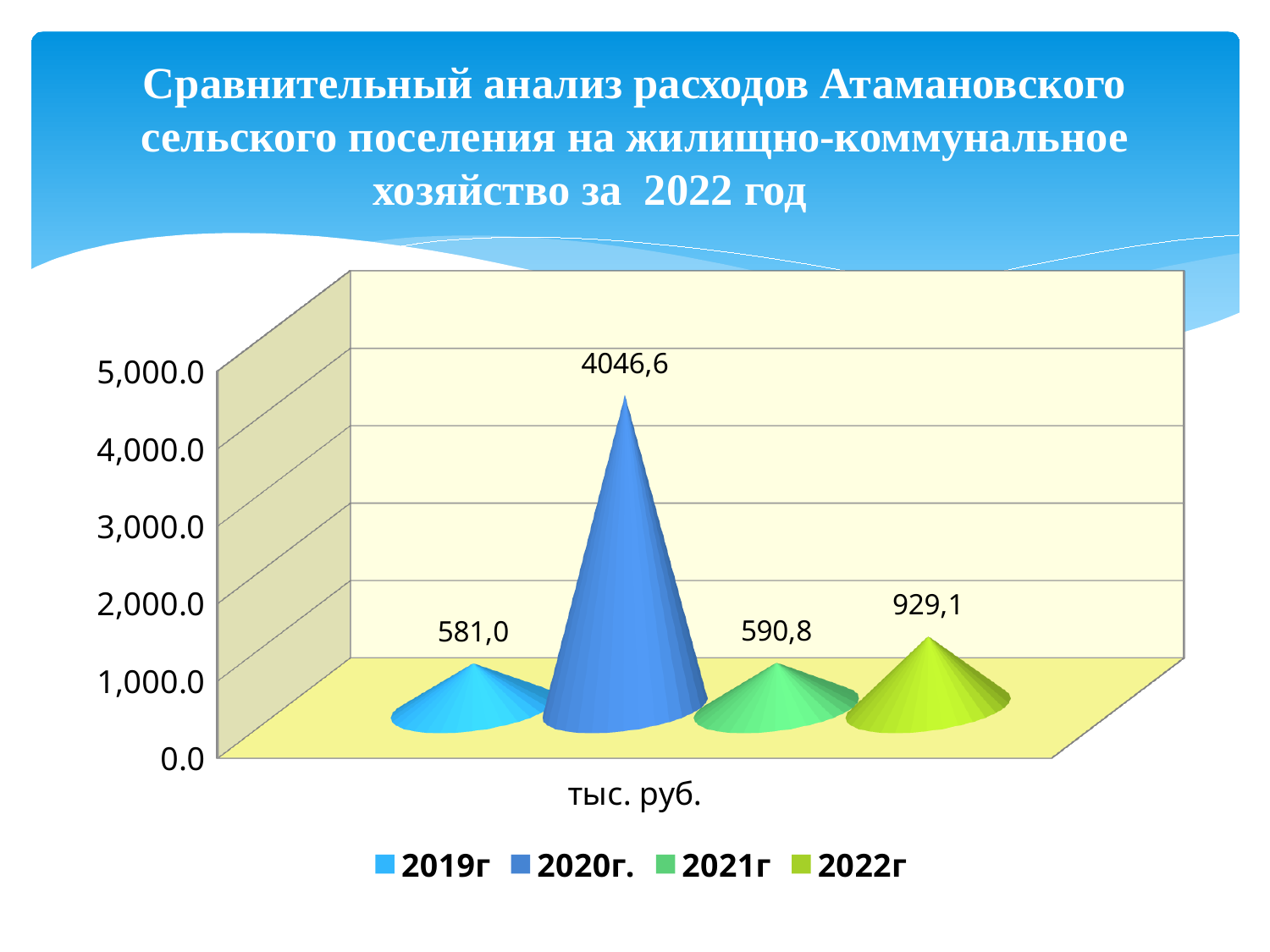
What is the value for 2022г on the chart? 929,1 Which year has the lowest value on the chart? 2019г How many series does the legend list? 4 What is the value for 2019г on the chart? 581,0 Which is larger, the value for 2022г or the value for 2021г? 2022г Is the value for 2020г. greater or less than 4,000.0? greater Which year has the highest value on the chart? 2020г. What unit label is shown under the chart's category axis? тыс. руб. What is the value for 2020г. on the chart? 4046,6 What is the difference between the values for 2020г. and 2022г? 3117,5 What kind of chart is shown on the slide? bar chart What is the value for 2021г on the chart? 590,8